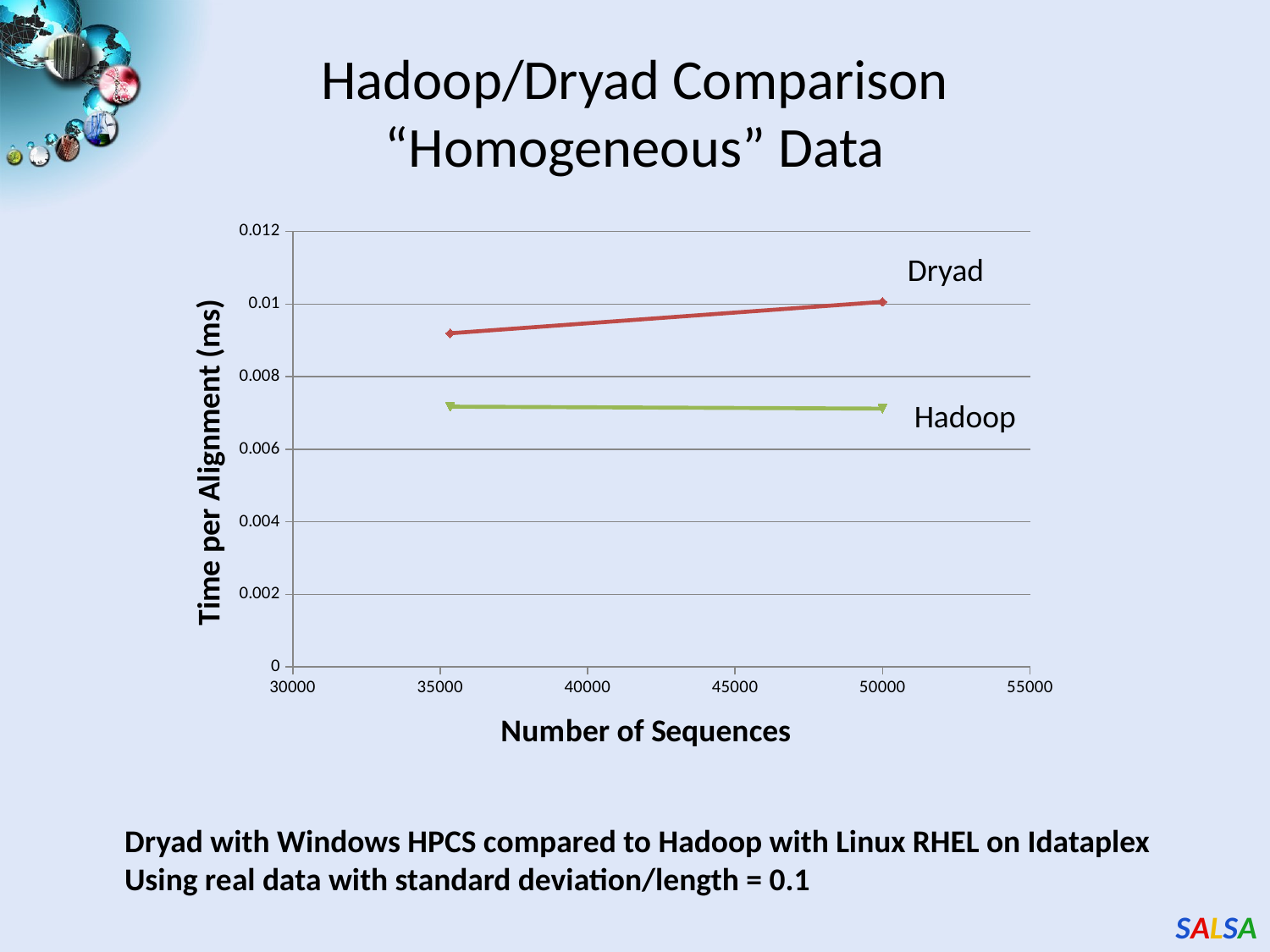
How many series are plotted on the chart? 2 How many data points are plotted for each series? 2 Does the Dryad line rise or fall as the number of sequences increases? rise Which series has the higher time per alignment across the plotted range, Dryad or Hadoop? Dryad Which series has the lowest time per alignment? Hadoop What kind of chart is shown on the slide? line chart Is the Dryad value at 50000 sequences greater or less than 0.008 ms? greater What is the label of the x axis? Number of Sequences Is the Hadoop value at 35000 sequences greater or less than 0.006 ms? greater Is the Hadoop value at 50000 sequences greater or less than 0.008 ms? less What is the label of the y axis? Time per Alignment (ms)